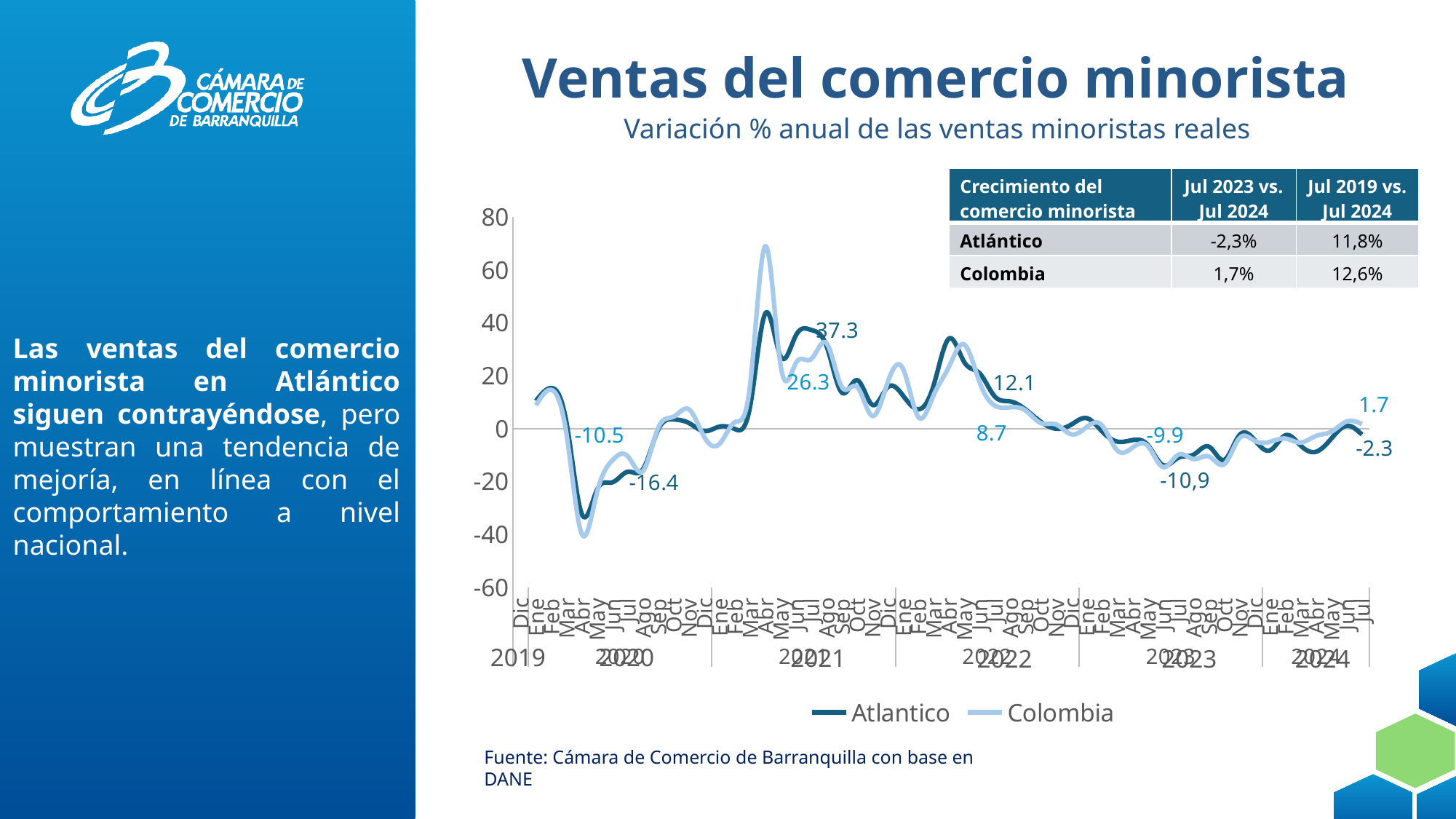
What is the last labelled value of the Atlantico series, at Jul 2024? -2.3 In the table, what is the growth of retail trade for Colombia for Jul 2023 vs. Jul 2024? 1,7% Is the peak of the Colombia line in 2021 greater or less than 60? greater What is the highest labelled value shown for the Atlantico series? 37.3 What are the two series named in the chart legend? Atlantico and Colombia How many series does the chart legend list? 2 At the end of the series (Jul 2024), which is higher, Atlantico or Colombia? Colombia In the table, what is the growth of retail trade for Atlántico for Jul 2019 vs. Jul 2024? 11,8% What kind of chart is shown on the slide? line chart What is the difference between the last labelled Colombia value (1.7) and the last labelled Atlantico value (-2.3)? 4.0 What is the last labelled value of the Colombia series, at Jul 2024? 1.7 Is the peak of the Atlantico line in 2021 greater or less than 60? less